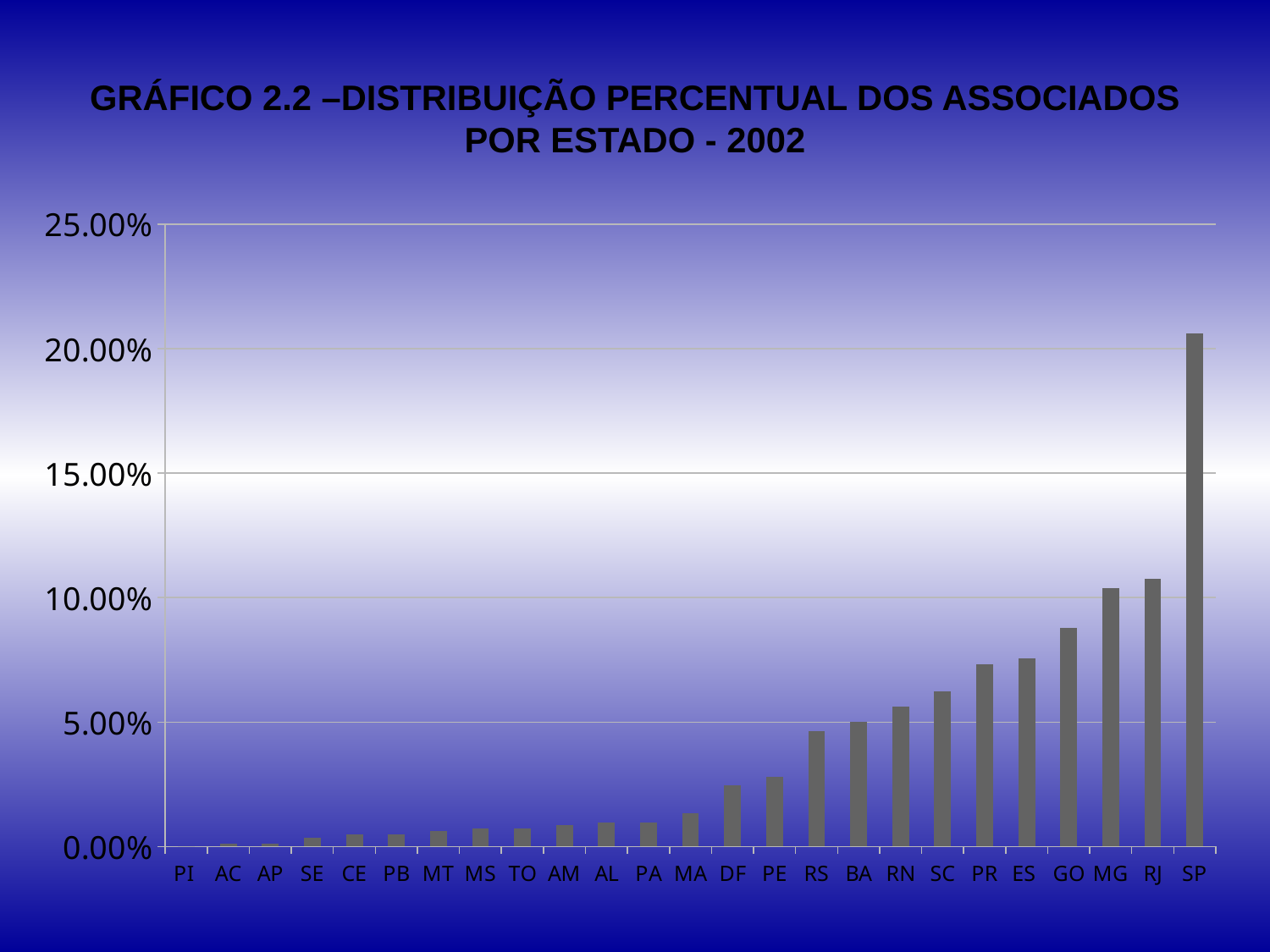
Is the value for RS greater or less than 5.00%? less How many states (categories) are shown on the x axis? 25 Which has a larger value, SP or RJ? SP Is the value for SP greater or less than 20.00%? greater Which has a larger value, GO or ES? GO Do the values generally rise or fall moving from left to right along the x axis? rise What kind of chart is shown on the slide? bar chart Is the value for PR greater or less than 5.00%? greater Which year does the chart title refer to? 2002 Which state has the highest percentage of associates? SP